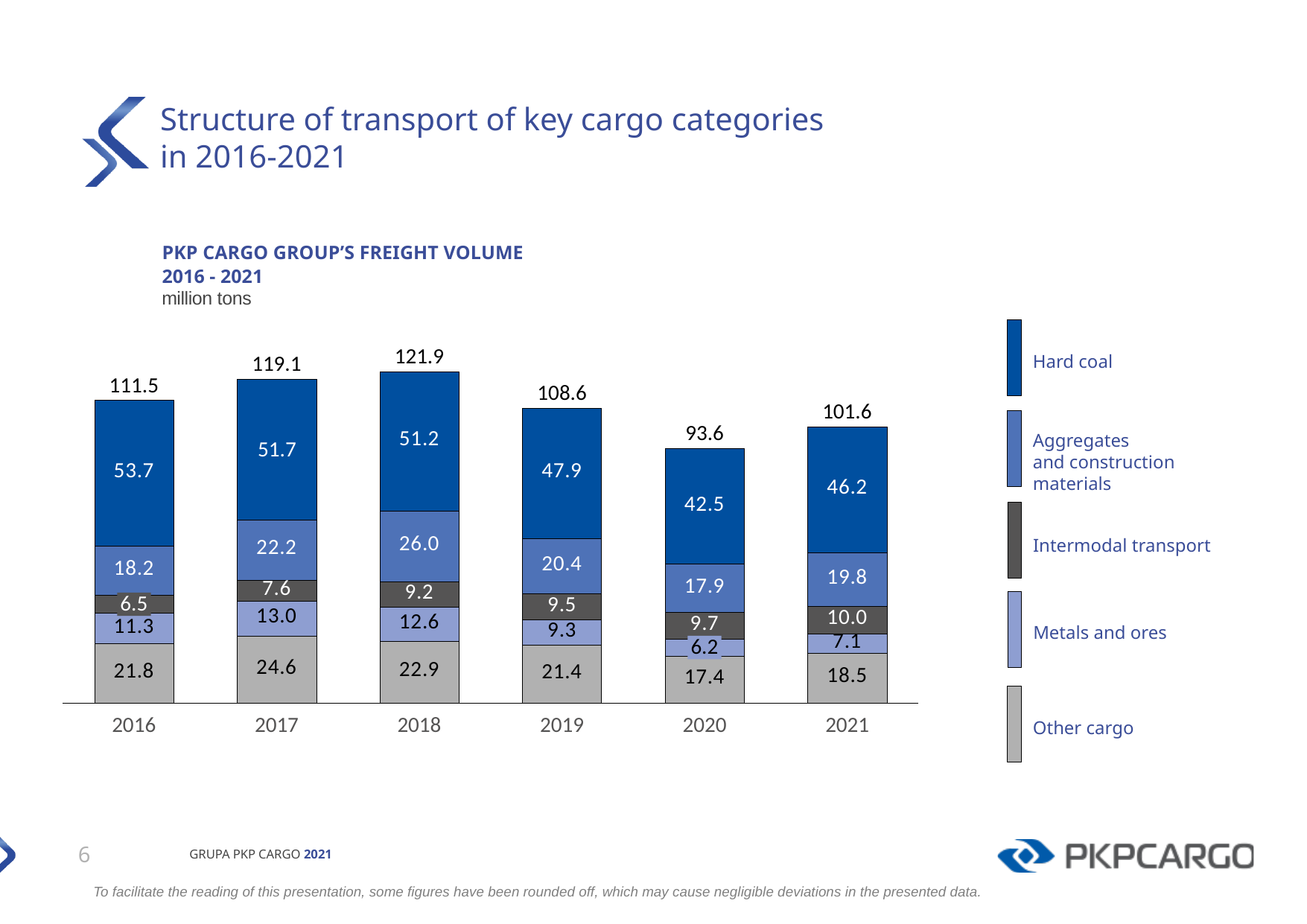
Which year had the lowest total freight volume? 2020 How many cargo categories does the legend list? 5 Which was larger in 2017: Aggregates and construction materials or Other cargo? Other cargo What is the total freight volume shown for 2019? 108.6 What was the Intermodal transport freight volume in 2021? 10.0 By how much did the Hard coal freight volume decrease from 2016 to 2021? 7.5 What kind of chart is used to show the freight volume? Stacked bar chart Which year had the highest total freight volume? 2018 How many years are shown on the x axis of the chart? 6 Did the Hard coal freight volume rise or fall from 2016 to 2020? Fall What was the Hard coal freight volume in 2018? 51.2 What was the Metals and ores freight volume in 2020? 6.2